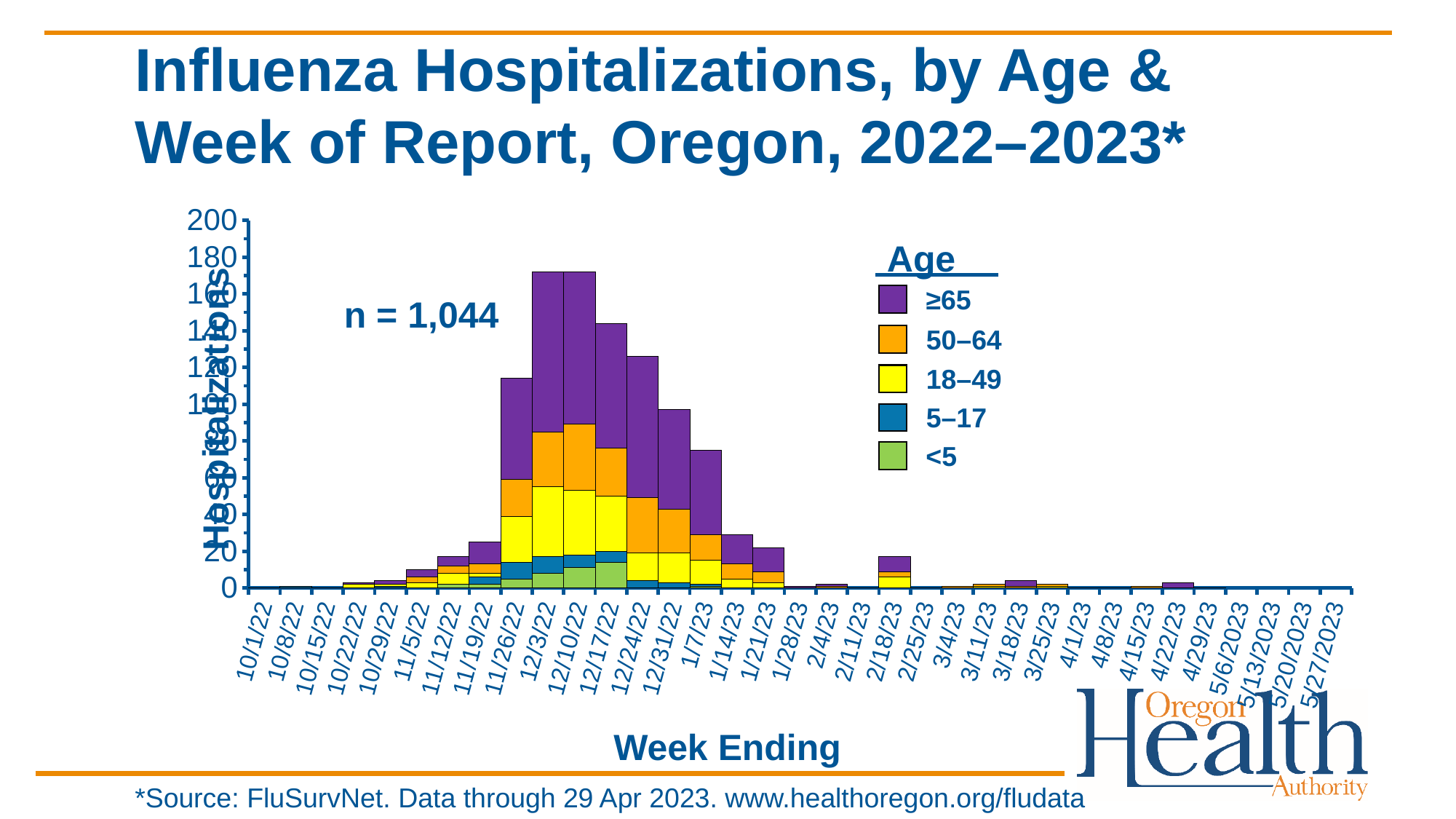
What is the value of n shown on the chart? n = 1,044 How many age groups does the legend list? 5 Do total hospitalizations rise or fall from the week ending 12/10/22 to the week ending 1/28/23? Fall Is the total number of hospitalizations for the week ending 12/3/22 greater or less than 160? greater Is the total number of hospitalizations for the week ending 1/21/23 greater or less than 40? less Which age groups are listed in the legend? ≥65, 50–64, 18–49, 5–17, <5 How many weeks are shown along the x axis? 35 Which age group makes up the largest segment of the bar for the week ending 12/3/22? ≥65 Which week has more total hospitalizations, 12/3/22 or 1/7/23? 12/3/22 Is the total number of hospitalizations for the week ending 1/7/23 greater or less than 60? greater What kind of chart is shown on the slide? Stacked bar chart